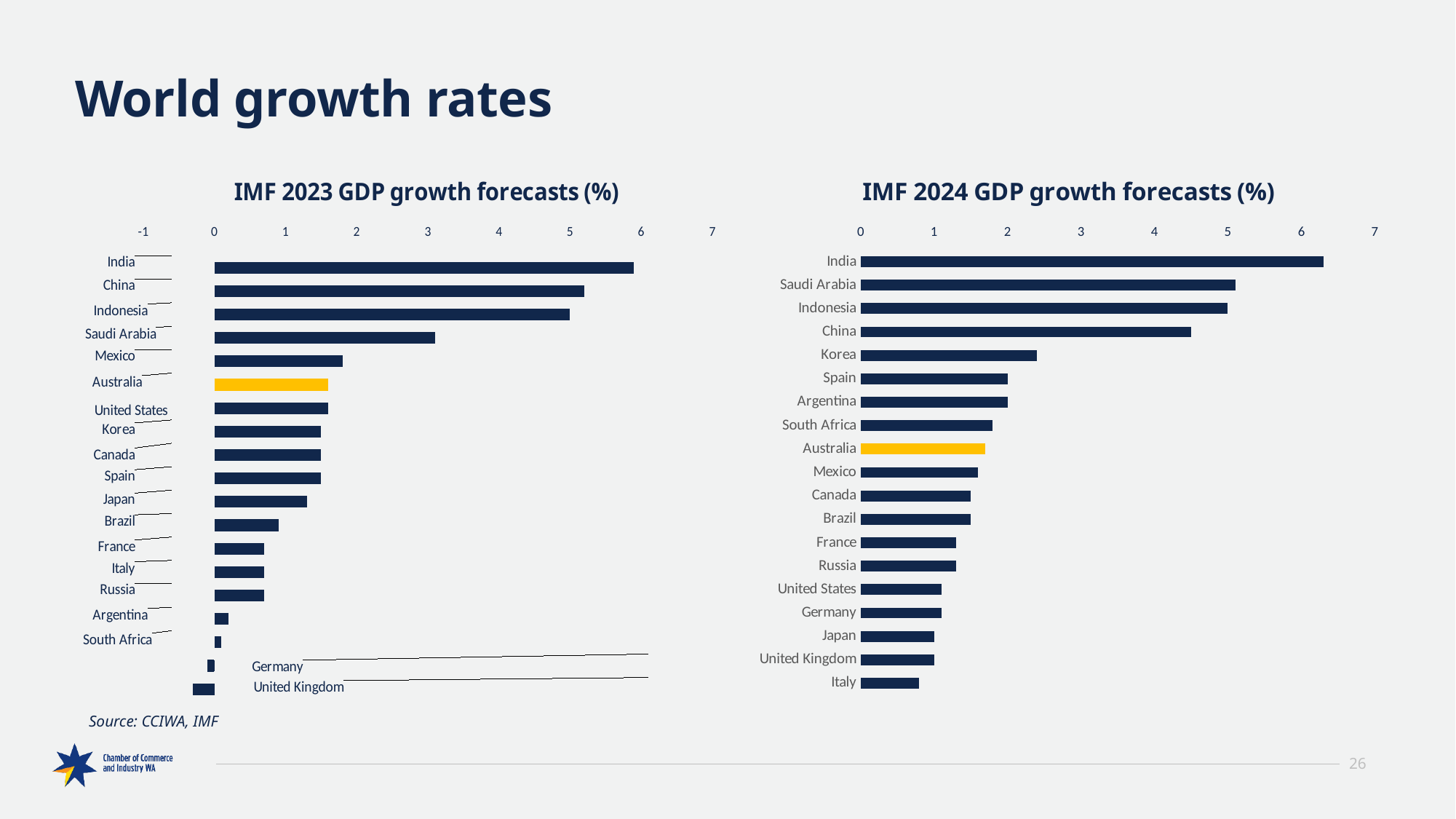
In the IMF 2023 GDP growth forecasts (%) chart, is the value for India greater or less than 5? greater In the IMF 2023 GDP growth forecasts (%) chart, is the value for Mexico greater or less than 2? less In the IMF 2024 GDP growth forecasts (%) chart, which is larger, the value for Korea or the value for Spain? Korea In the IMF 2023 GDP growth forecasts (%) chart, which country has the highest forecast? India How many countries are shown in the IMF 2023 GDP growth forecasts (%) chart? 19 In the IMF 2023 GDP growth forecasts (%) chart, which is larger, the value for Saudi Arabia or the value for Mexico? Saudi Arabia In the IMF 2024 GDP growth forecasts (%) chart, is the value for China greater or less than 4? greater In the IMF 2024 GDP growth forecasts (%) chart, which country has the highest forecast? India What kind of chart is the IMF 2023 GDP growth forecasts (%) chart? Bar chart In the IMF 2023 GDP growth forecasts (%) chart, which country has the lowest forecast? United Kingdom In the IMF 2024 GDP growth forecasts (%) chart, which country has the lowest forecast? Italy In the IMF 2024 GDP growth forecasts (%) chart, which country's bar is highlighted in yellow? Australia